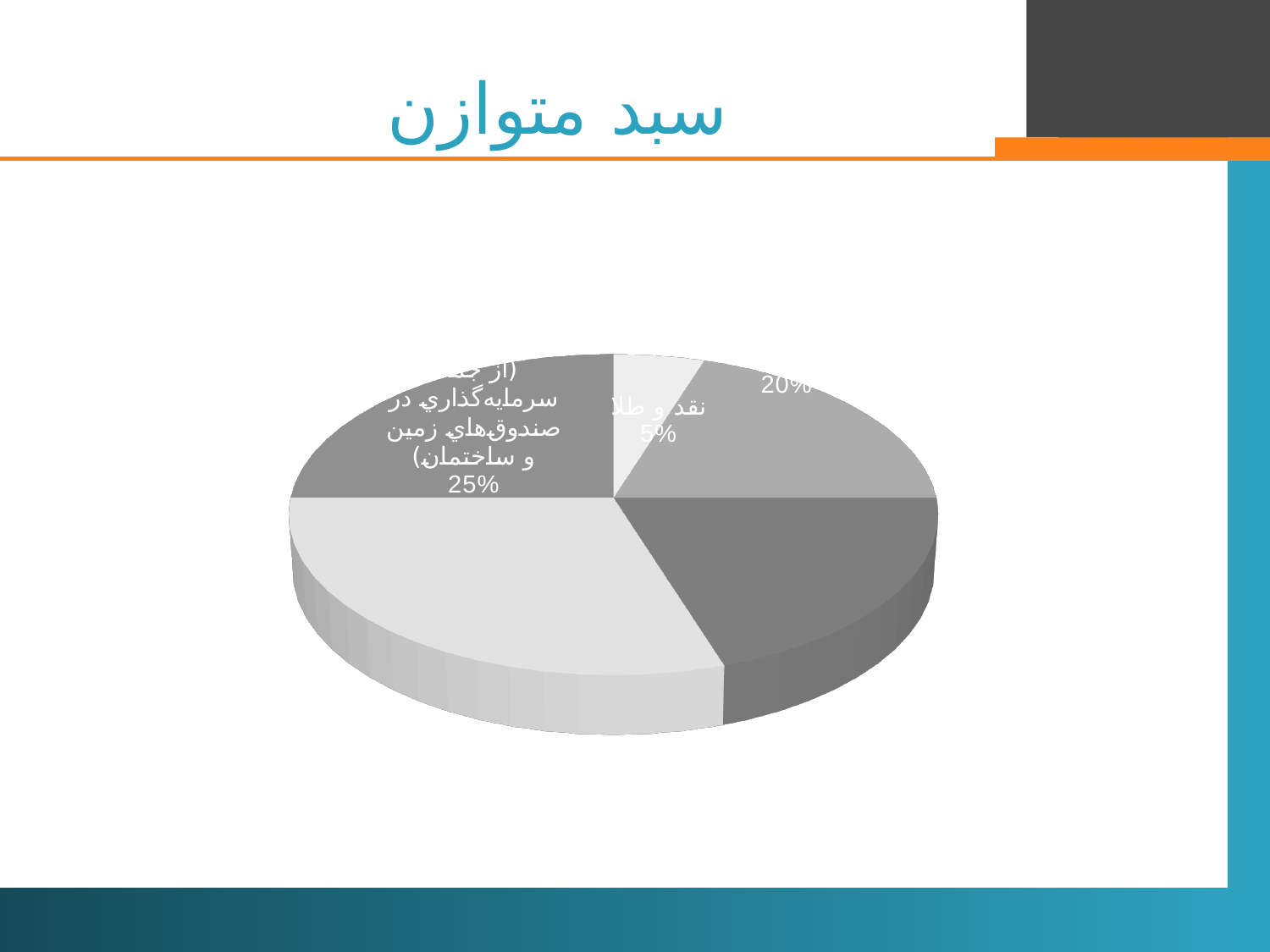
What kind of chart is shown on the slide? pie chart Which is larger: the slice for نقد و طلا or the slice mentioning land and building funds (صندوق‌های زمین و ساختمان)? the land and building funds slice (صندوق‌های زمین و ساختمان) Which slice of the pie is the smallest? نقد و طلا What is the title of the chart on the slide? سبد متوازن What share of the pie is labelled نقد و طلا (cash and gold)? 5% What percentage is shown for the slice whose label mentions investment in land and building funds (صندوق‌های زمین و ساختمان)? 25% How many slices does the pie chart have? 5 What is the difference in percentage points between the slice mentioning land and building funds (25%) and the نقد و طلا slice (5%)? 20%